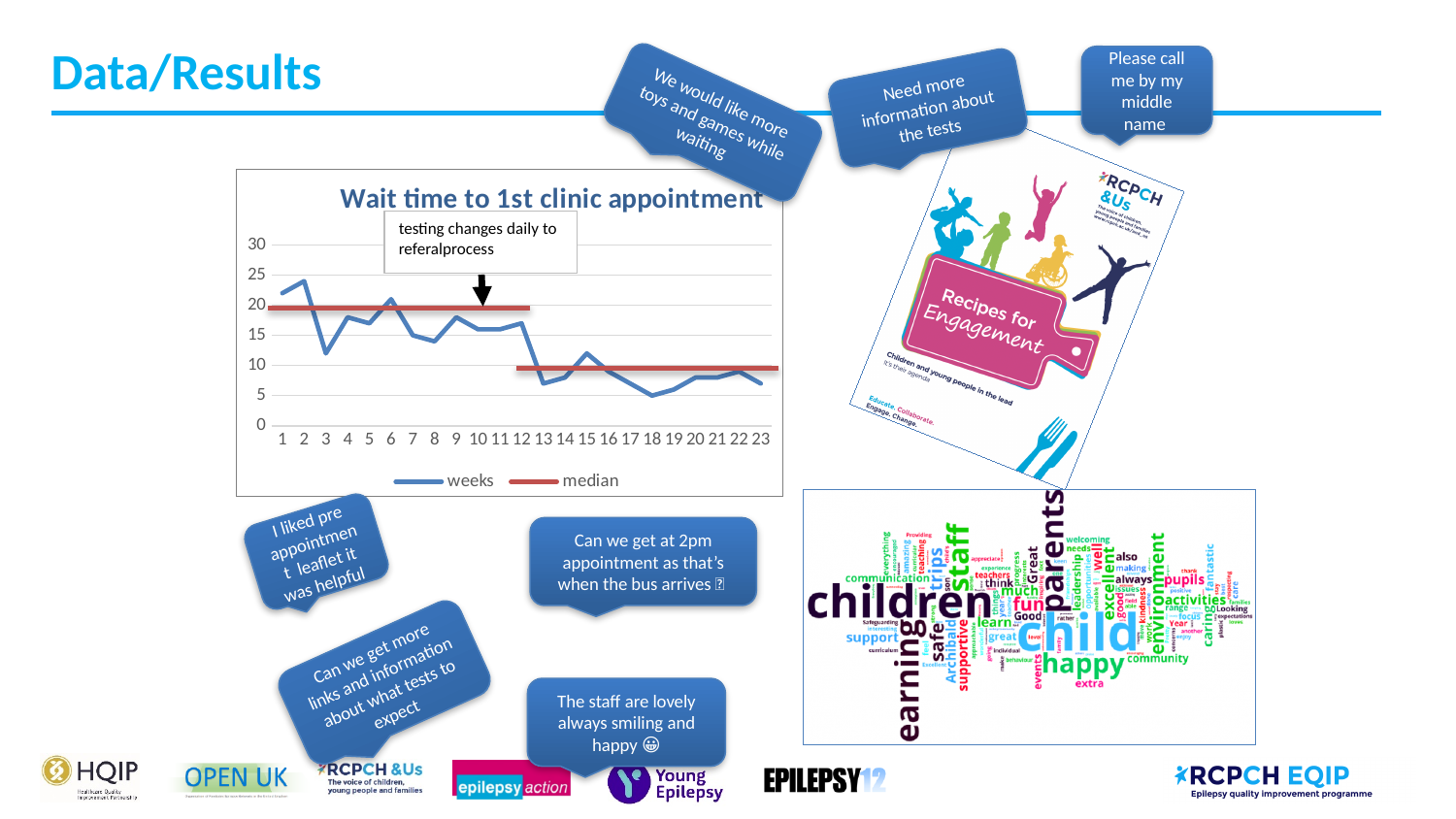
How many points are plotted along the x axis of the chart? 23 Is the value of the weeks series at point 23 greater or less than 10? less At which x-axis point does the weeks series reach its highest value? 2 How many series does the chart legend list? 2 At which x-axis point does the weeks series reach its lowest value? 18 What are the two series named in the chart legend? weeks and median Overall, does the weeks series rise or fall from point 1 to point 23? fall Is the value of the weeks series at point 2 greater or less than 20? greater What type of chart is shown on the slide? line chart What is the title of the chart? Wait time to 1st clinic appointment Is the value of the weeks series at point 18 greater or less than 10? less